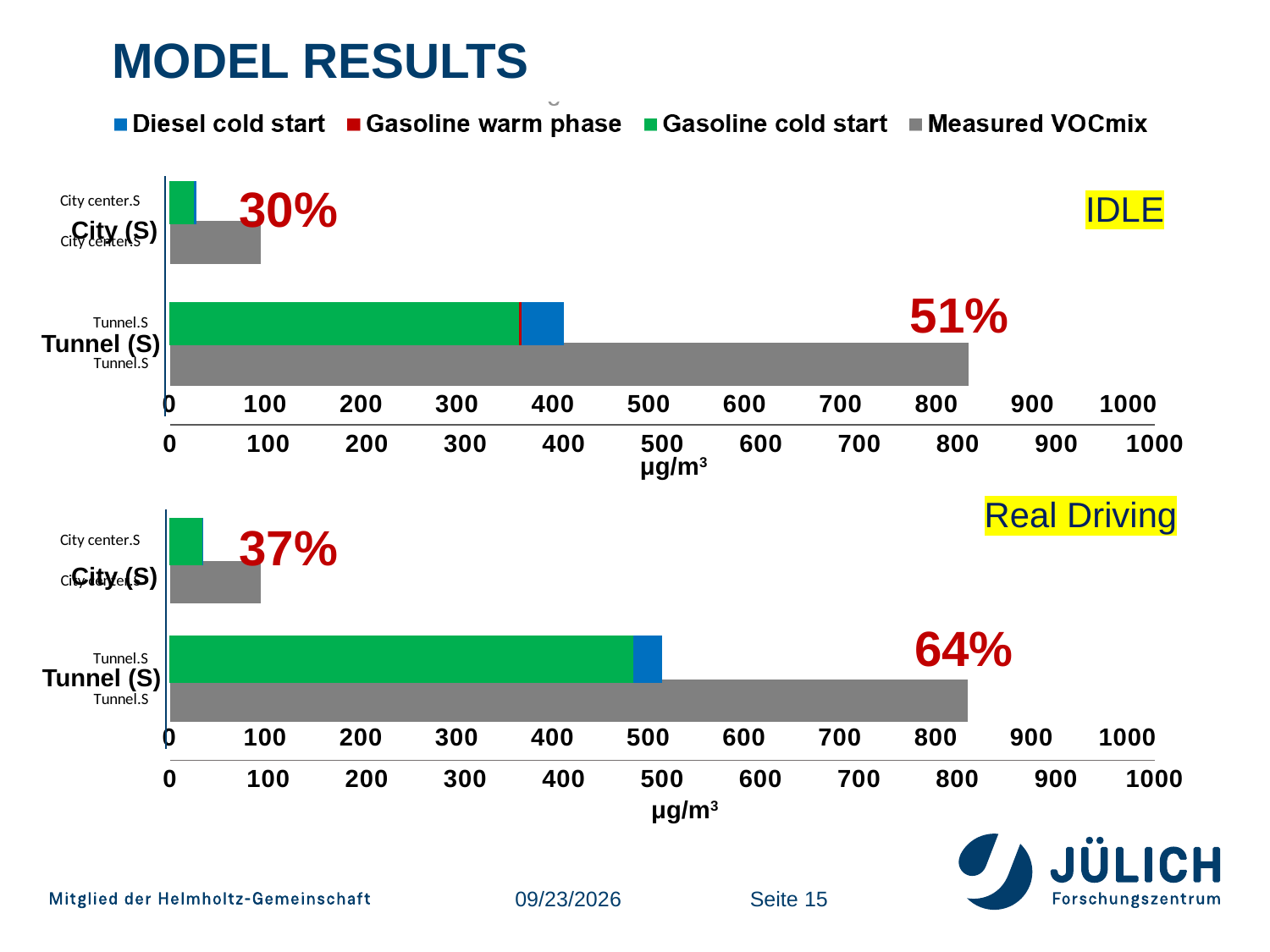
In the Real Driving chart, is the total of the stacked modelled bar (Gasoline cold start plus Diesel cold start) for Tunnel (S) greater or less than 400? greater What kind of chart is the Real Driving chart? Bar chart In the IDLE chart, what percentage label is shown next to the Tunnel (S) bars? 51% In the Real Driving chart, what percentage label is shown next to the Tunnel (S) bars? 64% In the IDLE chart, which category has the longer Measured VOCmix bar, City (S) or Tunnel (S)? Tunnel (S) How many series does the legend at the top of the slide list? 4 How many categories are plotted in the IDLE chart? 2 In the IDLE chart, is the Measured VOCmix value for City (S) greater or less than 200? less In the IDLE chart, what percentage label is shown next to the City (S) bars? 30% In the Real Driving chart, what percentage label is shown next to the City (S) bars? 37% What unit is shown on the x axis of the charts? µg/m³ In the Real Driving chart, is the Measured VOCmix value for Tunnel (S) greater or less than 700? greater